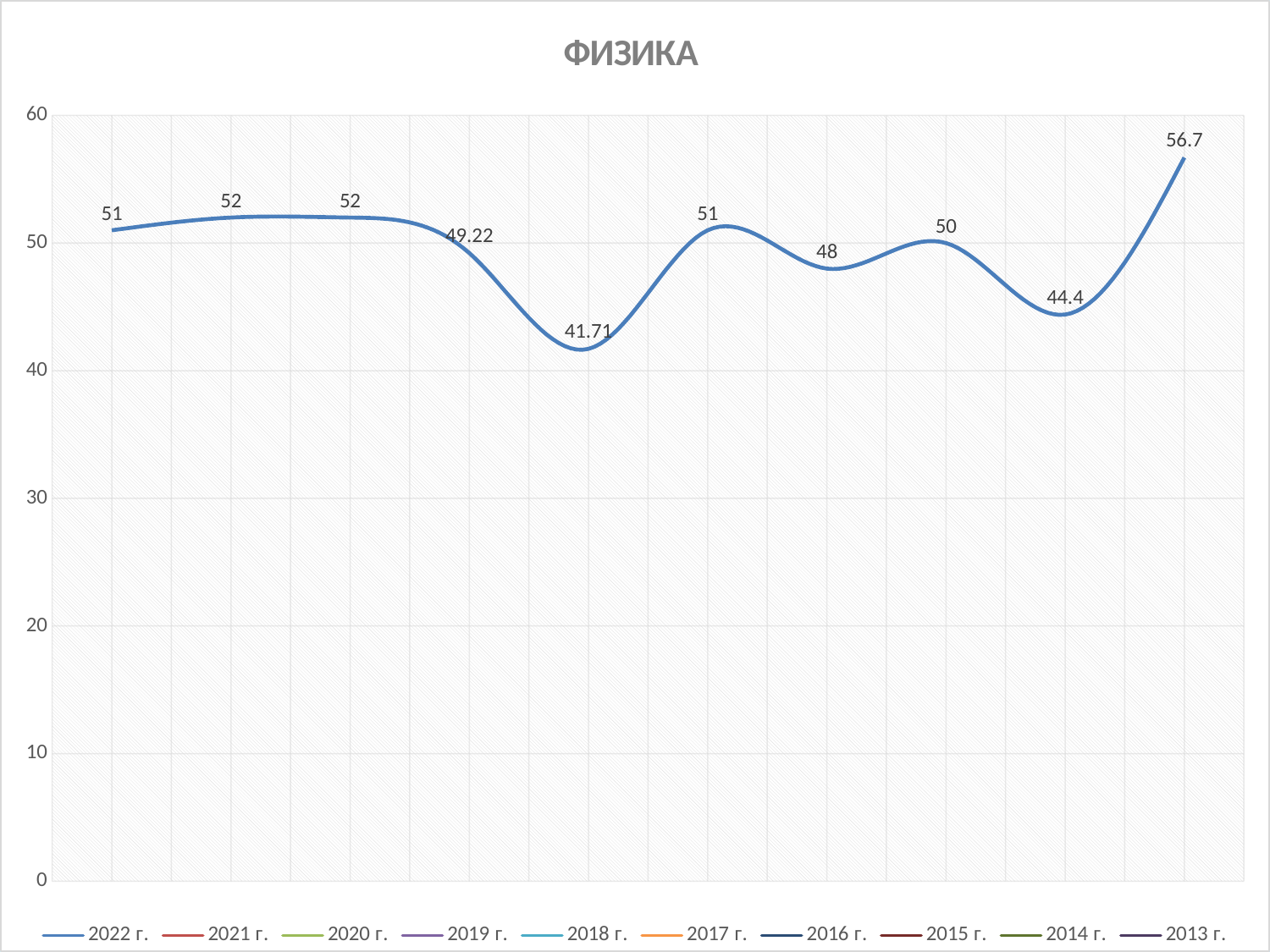
What is the title of the chart? ФИЗИКА What is the difference between the highest labelled value (56.7) and the lowest labelled value (41.71)? 14.99 Which is larger: the point labelled 49.22 or the point labelled 48? 49.22 Is the lowest point on the line greater or less than 40? greater How many entries does the legend list? 10 What is the lowest value labelled on the line? 41.71 How many data points are plotted on the line? 10 What is the value of the first (leftmost) point on the line? 51 What is the highest value labelled on the line? 56.7 Does the line rise or fall between the second-to-last point (44.4) and the last point (56.7)? rises What is the value of the last (rightmost) point on the line? 56.7 What kind of chart is shown on the slide? line chart